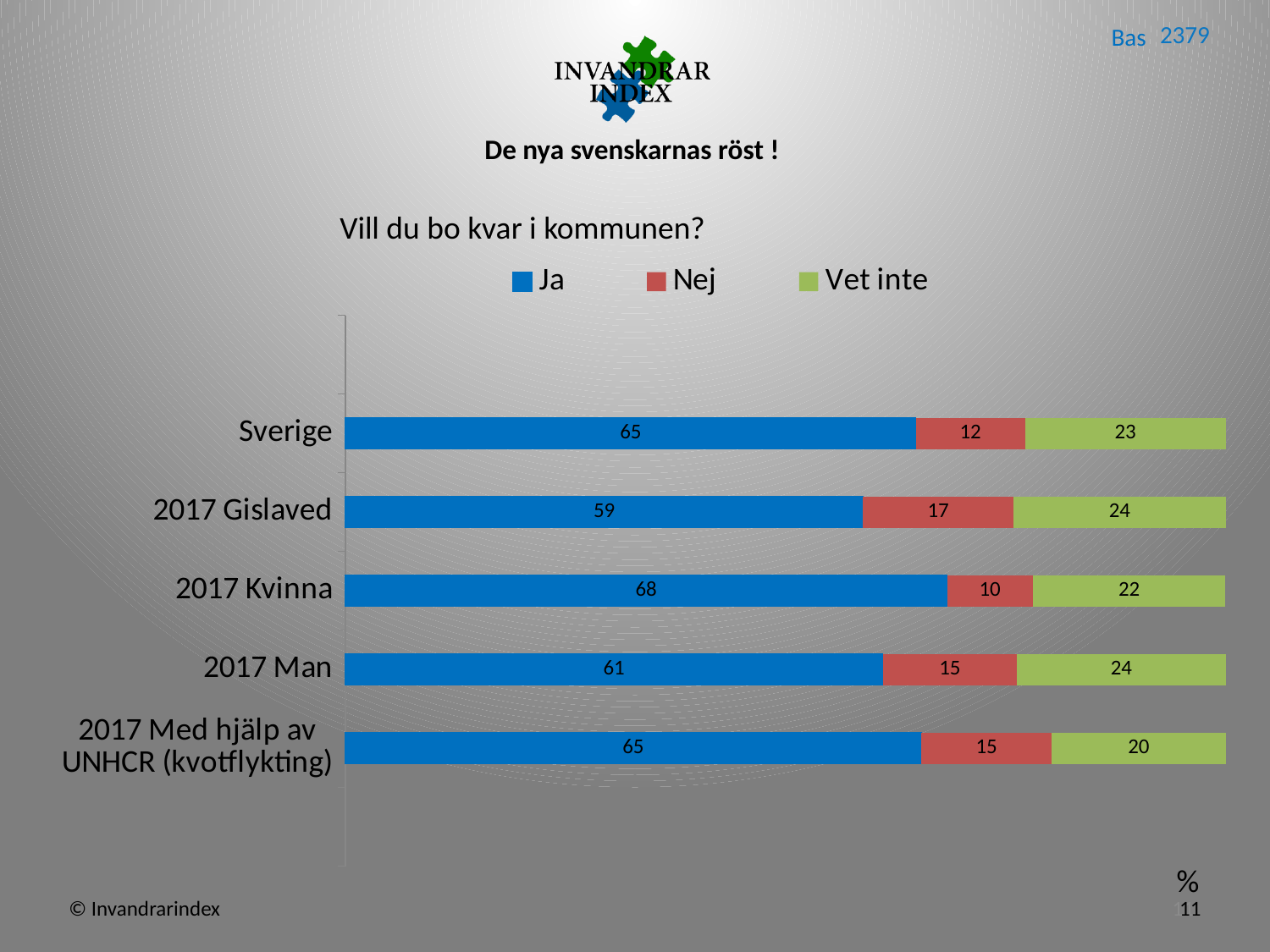
Which is larger, the "Nej" value for Sverige or for 2017 Man? 2017 Man Which category has the highest "Ja" value? 2017 Kvinna What is the difference between the "Ja" values for 2017 Kvinna and 2017 Man? 7 What is the total of the stacked bar for Sverige? 100 What is the value of "Nej" for 2017 Gislaved? 17 Which category has the lowest "Ja" value? 2017 Gislaved What kind of chart is shown? Stacked bar chart How many series does the legend list? 3 What is the title of the chart? Vill du bo kvar i kommunen? What is the value of "Ja" for 2017 Kvinna? 68 What is the value of "Vet inte" for 2017 Med hjälp av UNHCR (kvotflykting)? 20 How many categories are shown on the chart? 5